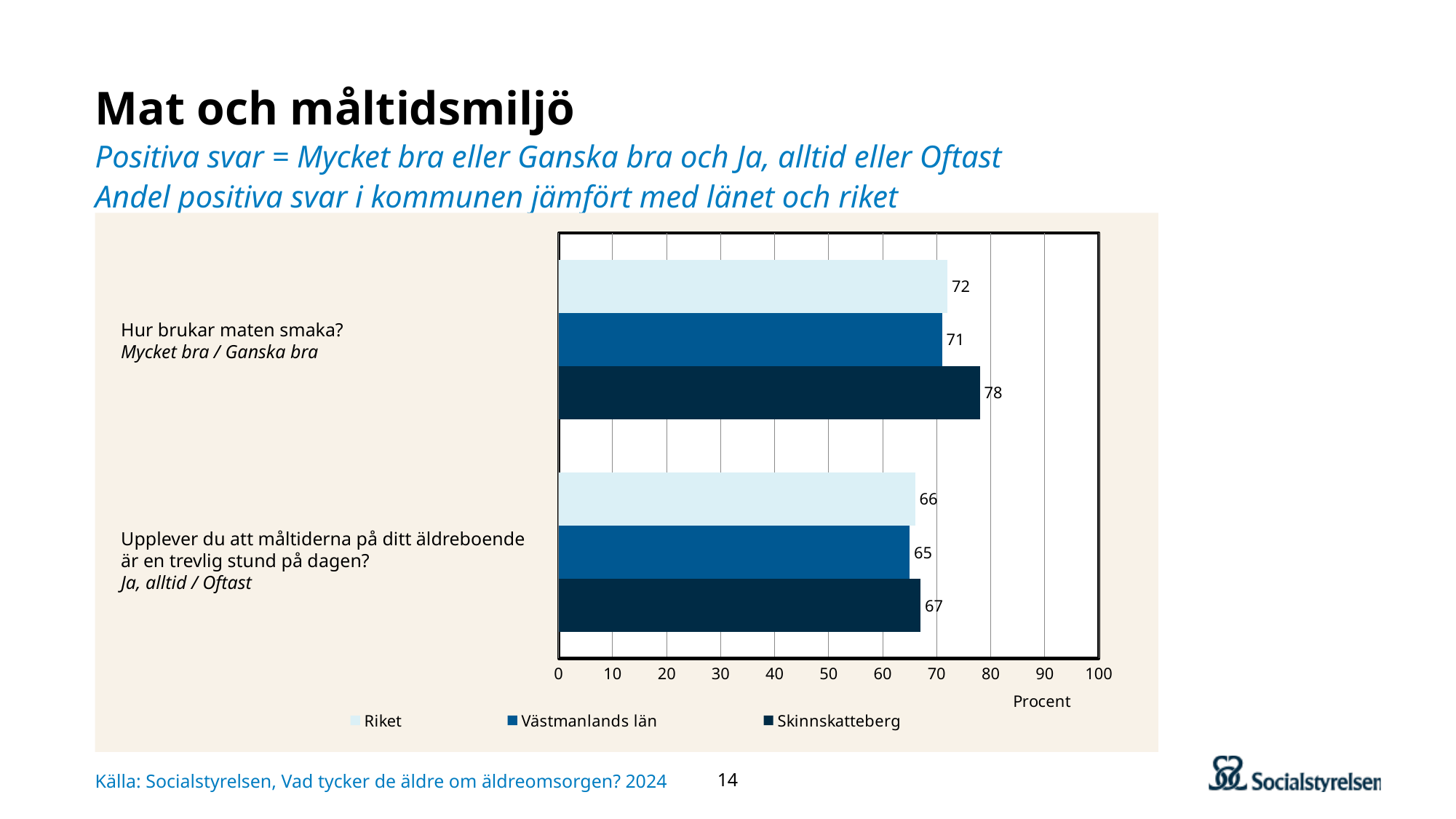
Which is larger for "Upplever du att måltiderna på ditt äldreboende är en trevlig stund på dagen?": Riket or Skinnskatteberg? Skinnskatteberg What kind of chart is shown on the slide? Bar chart What is the value for Skinnskatteberg on the question "Hur brukar maten smaka?"? 78 How many series does the legend list? 3 Which series has the lowest value for "Upplever du att måltiderna på ditt äldreboende är en trevlig stund på dagen?"? Västmanlands län What is the value for Riket on the question "Upplever du att måltiderna på ditt äldreboende är en trevlig stund på dagen?"? 66 What is the value for Västmanlands län on the question "Hur brukar maten smaka?"? 71 Is the value for Skinnskatteberg on "Hur brukar maten smaka?" greater or less than 70? greater What unit is shown on the horizontal axis of the chart? Procent How many questions (categories) are shown in the chart? 2 Which series has the highest value for "Hur brukar maten smaka?"? Skinnskatteberg What is the difference between the Skinnskatteberg and Riket values for "Hur brukar maten smaka?"? 6